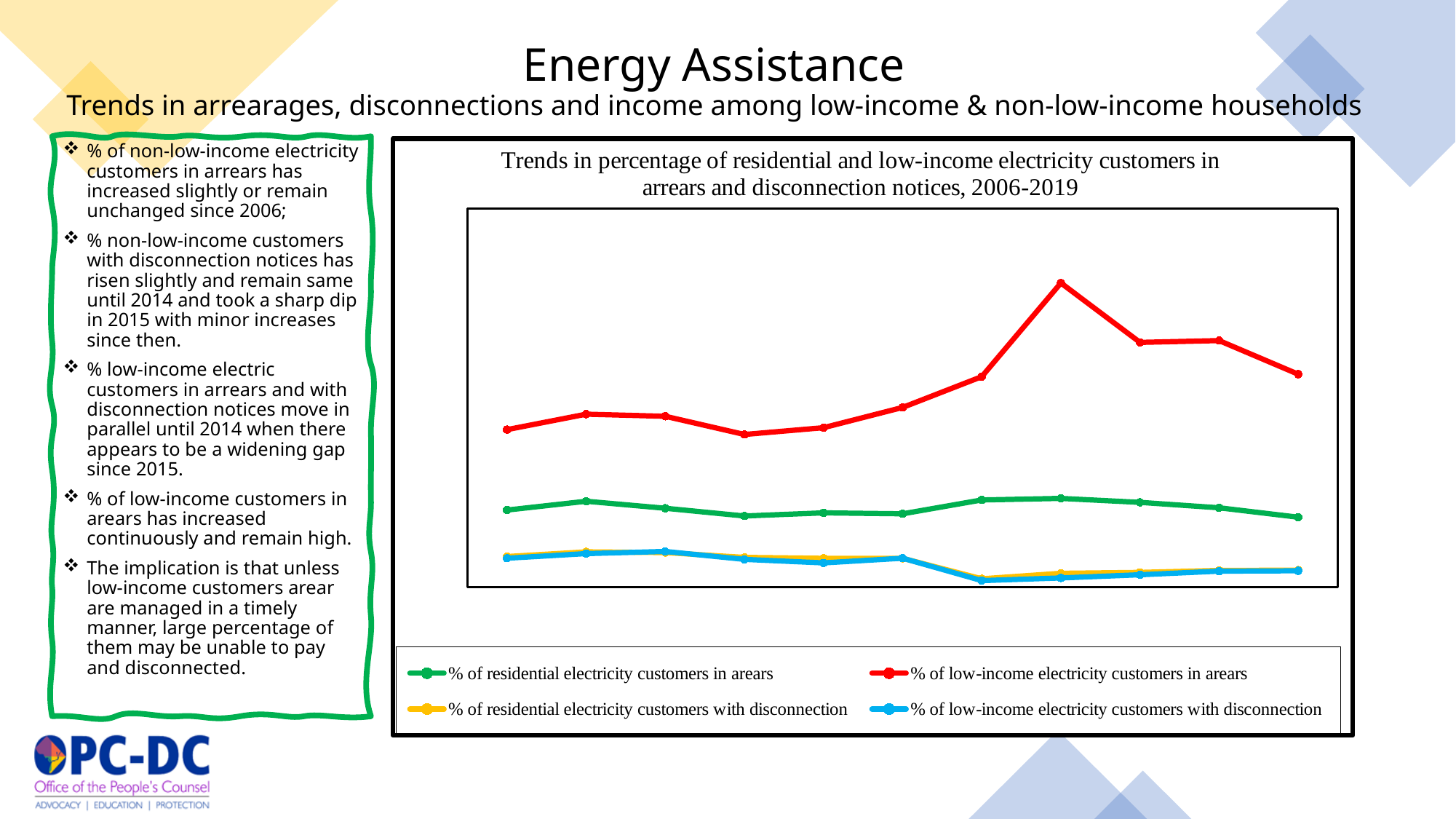
Which is higher across the chart: % of residential electricity customers in arears or % of low-income electricity customers in arears? % of low-income electricity customers in arears How many series does the chart's legend list? 4 What kind of chart is shown on the slide? line chart Does the line for % of low-income electricity customers in arears end higher or lower than it starts? higher What is the title of the chart? Trends in percentage of residential and low-income electricity customers in arrears and disconnection notices, 2006-2019 What colour is the line for % of low-income electricity customers in arears? red Which series has the highest values throughout the chart? % of low-income electricity customers in arears Does the line for % of low-income electricity customers with disconnection end higher or lower than it starts? lower Which is higher across the chart: % of residential electricity customers in arears or % of residential electricity customers with disconnection? % of residential electricity customers in arears Which is higher across the chart: % of low-income electricity customers in arears or % of low-income electricity customers with disconnection? % of low-income electricity customers in arears